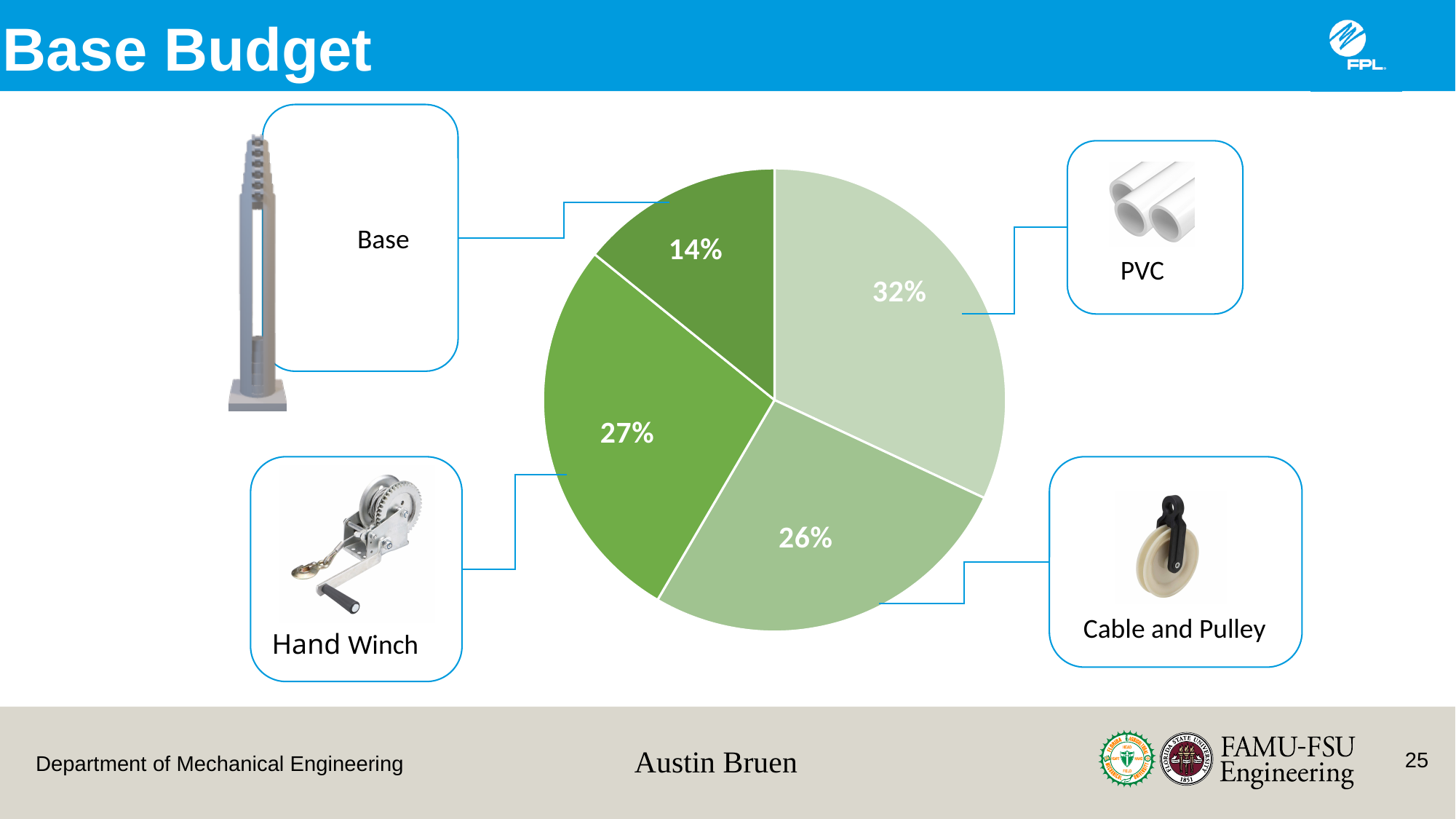
What is the title of the slide containing the pie chart? Base Budget What is the difference in percentage points between the Hand Winch share and the Cable and Pulley share? 1 What is the difference in percentage points between the PVC share and the Base share? 18 Which component takes the smallest share of the base budget? Base Which has the larger share of the base budget, PVC or Cable and Pulley? PVC What kind of chart is shown on the slide? pie chart What share of the base budget does the Base account for? 14% How many slices does the pie chart have? 4 What share of the base budget does the Hand Winch account for? 27% What share of the base budget does Cable and Pulley account for? 26% Which component takes the largest share of the base budget? PVC What share of the base budget does PVC account for? 32%